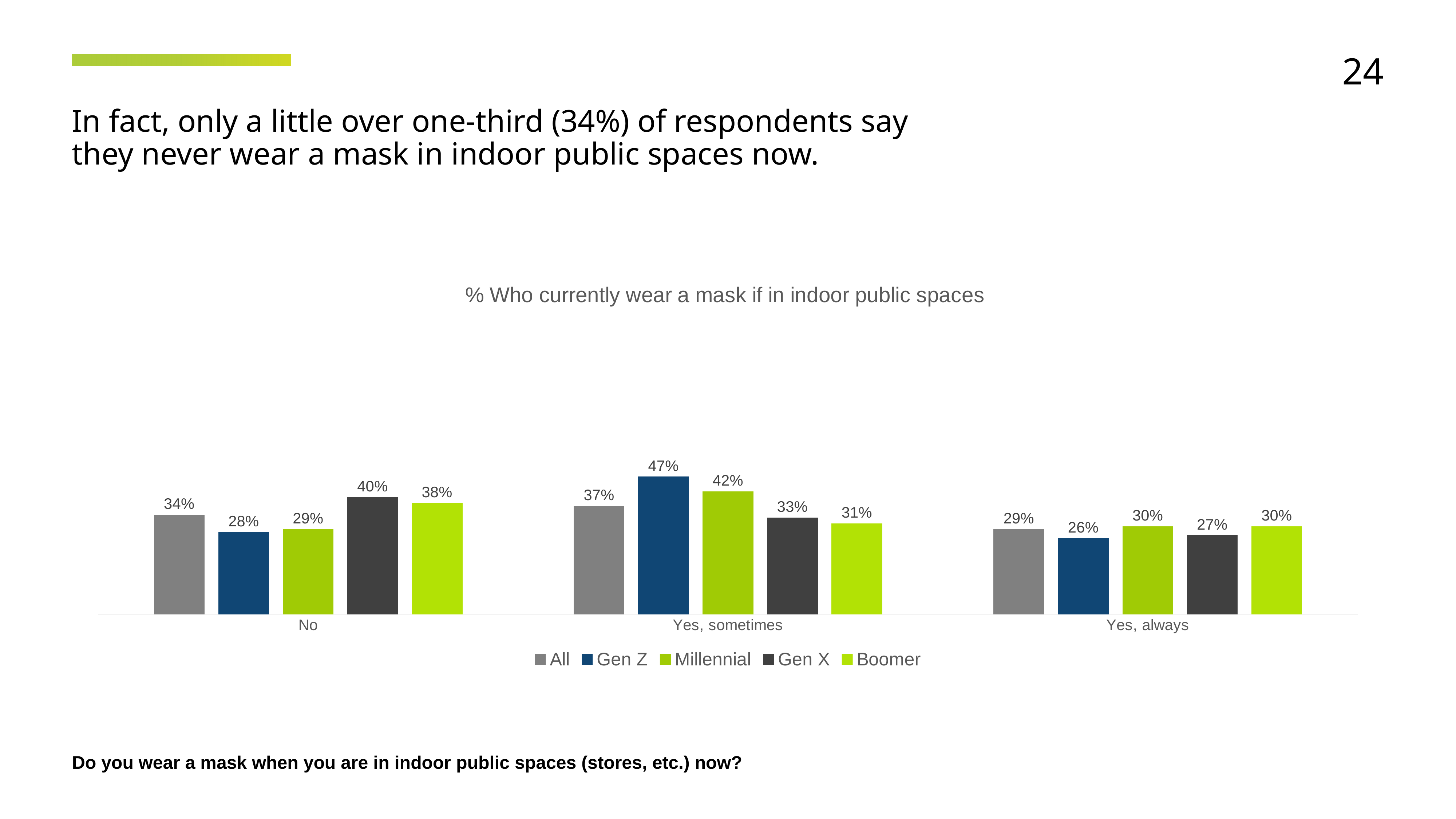
What is the title of the chart? % Who currently wear a mask if in indoor public spaces Which series has the highest value in the "Yes, sometimes" category? Gen Z How many series does the legend list? 5 In the "No" category, which is larger: the Gen X value or the Millennial value? Gen X What is the value for Boomer in the "Yes, always" category? 30% What is the difference between the Gen Z and Gen X values in the "Yes, sometimes" category? 14% What is the value for Gen X in the "No" category? 40% What percentage of Gen Z respondents answered "Yes, sometimes"? 47% How many response categories are shown on the x axis? 3 Which series has the lowest value in the "No" category? Gen Z What kind of chart is shown on the slide? Bar chart What is the difference between the All values for "Yes, sometimes" and "Yes, always"? 8%